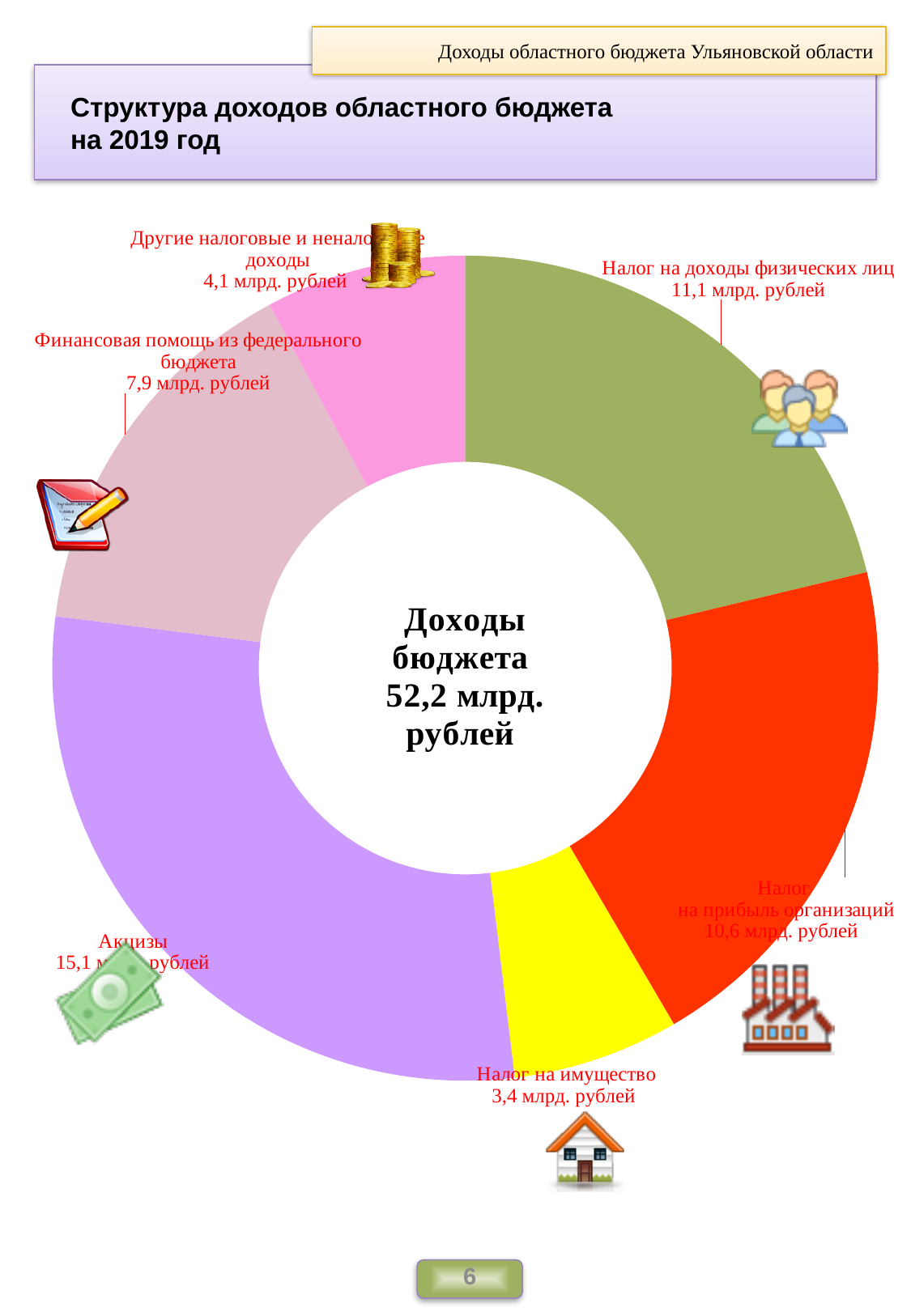
What is the value for Налог на имущество? 3,4 млрд. рублей What is the difference between Акцизы and Налог на доходы физических лиц? 4,0 млрд. рублей What is the value for Финансовая помощь из федерального бюджета? 7,9 млрд. рублей What kind of chart is shown on the slide? doughnut (pie) chart What total is shown in the centre of the chart? 52,2 млрд. рублей Which category has the largest value? Акцизы Which category has the smallest value? Налог на имущество What is the value for Акцизы? 15,1 млрд. рублей Which is larger: Налог на прибыль организаций or Финансовая помощь из федерального бюджета? Налог на прибыль организаций How many categories does the chart show? 6 What is the value for Налог на доходы физических лиц? 11,1 млрд. рублей What is the difference between Финансовая помощь из федерального бюджета and Другие налоговые и неналоговые доходы? 3,8 млрд. рублей